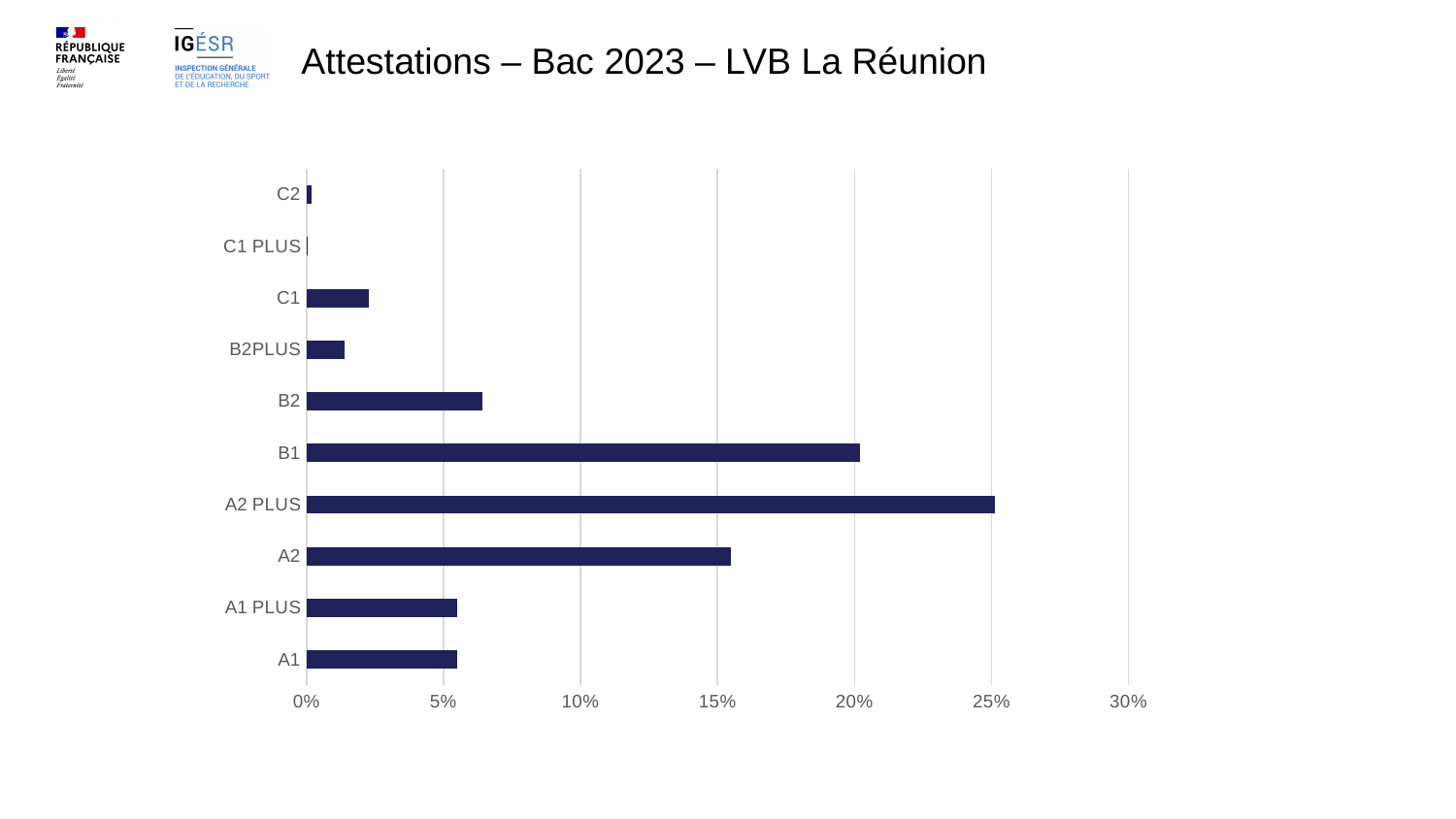
What is the title of the slide containing the chart? Attestations – Bac 2023 – LVB La Réunion Is the value for A2 PLUS greater or less than 20%? greater How many categories (levels) are plotted on the chart? 10 Is the value for B2 greater or less than 10%? less Is the value for A2 greater or less than 20%? less What kind of chart is shown on the slide? bar chart Which is larger, the value for B1 or the value for A2? B1 Which is larger, the value for B2 or the value for C1? B2 Which level has the highest value on the chart? A2 PLUS Which level has the lowest value on the chart? C1 PLUS